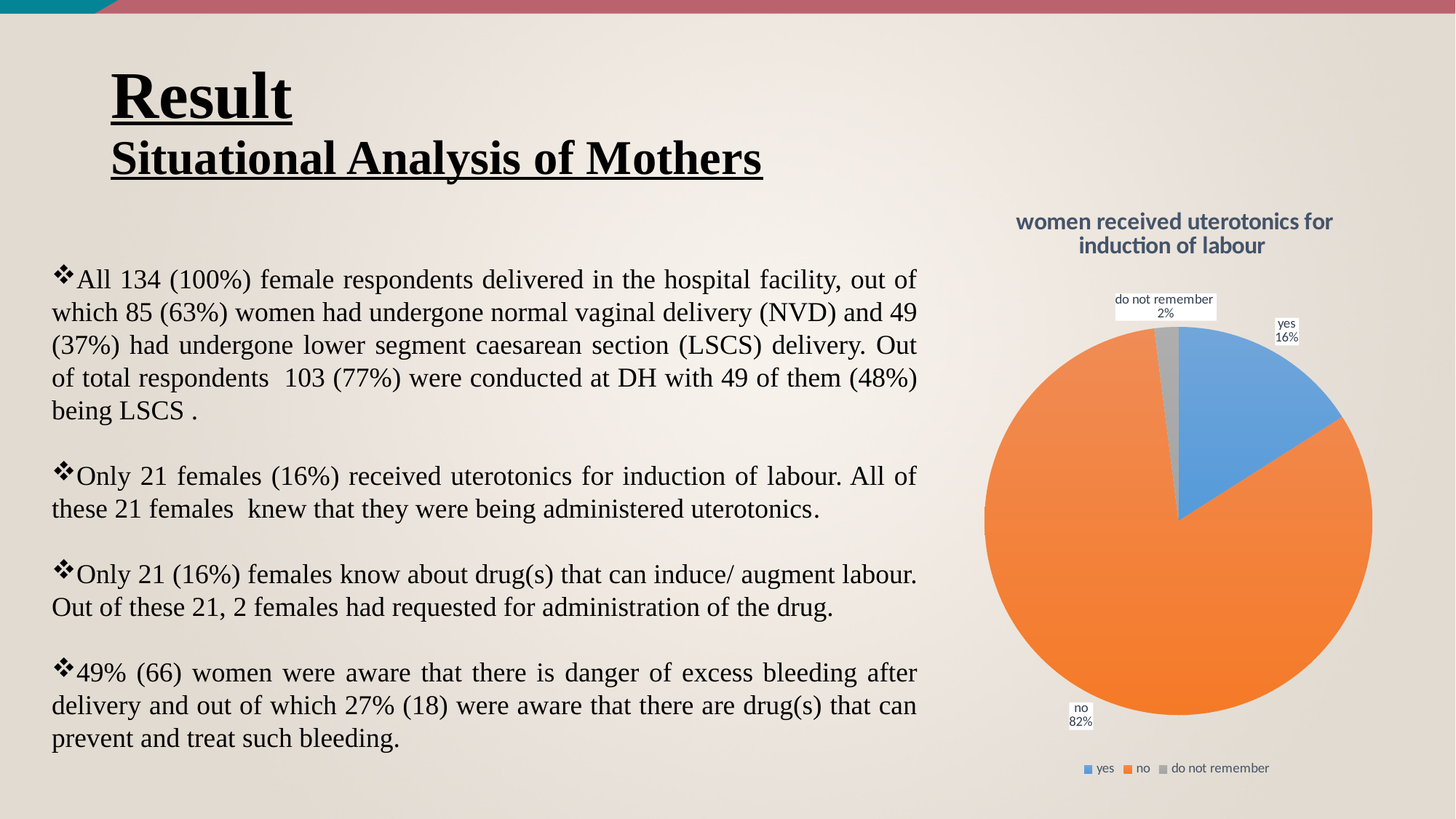
What is the title of the chart? women received uterotonics for induction of labour Which slice is larger, "yes" or "do not remember"? yes What type of chart is shown on the slide? pie chart What percentage of the pie is labelled "no"? 82% What colour is the "no" slice? orange Which category has the smallest share of the pie? do not remember How many slices does the pie chart have? 3 What is the difference in percentage points between the "no" and "yes" slices? 66 What percentage of the pie is labelled "yes"? 16% How many entries does the legend list? 3 What percentage of the pie is labelled "do not remember"? 2% Which category has the largest share of the pie? no